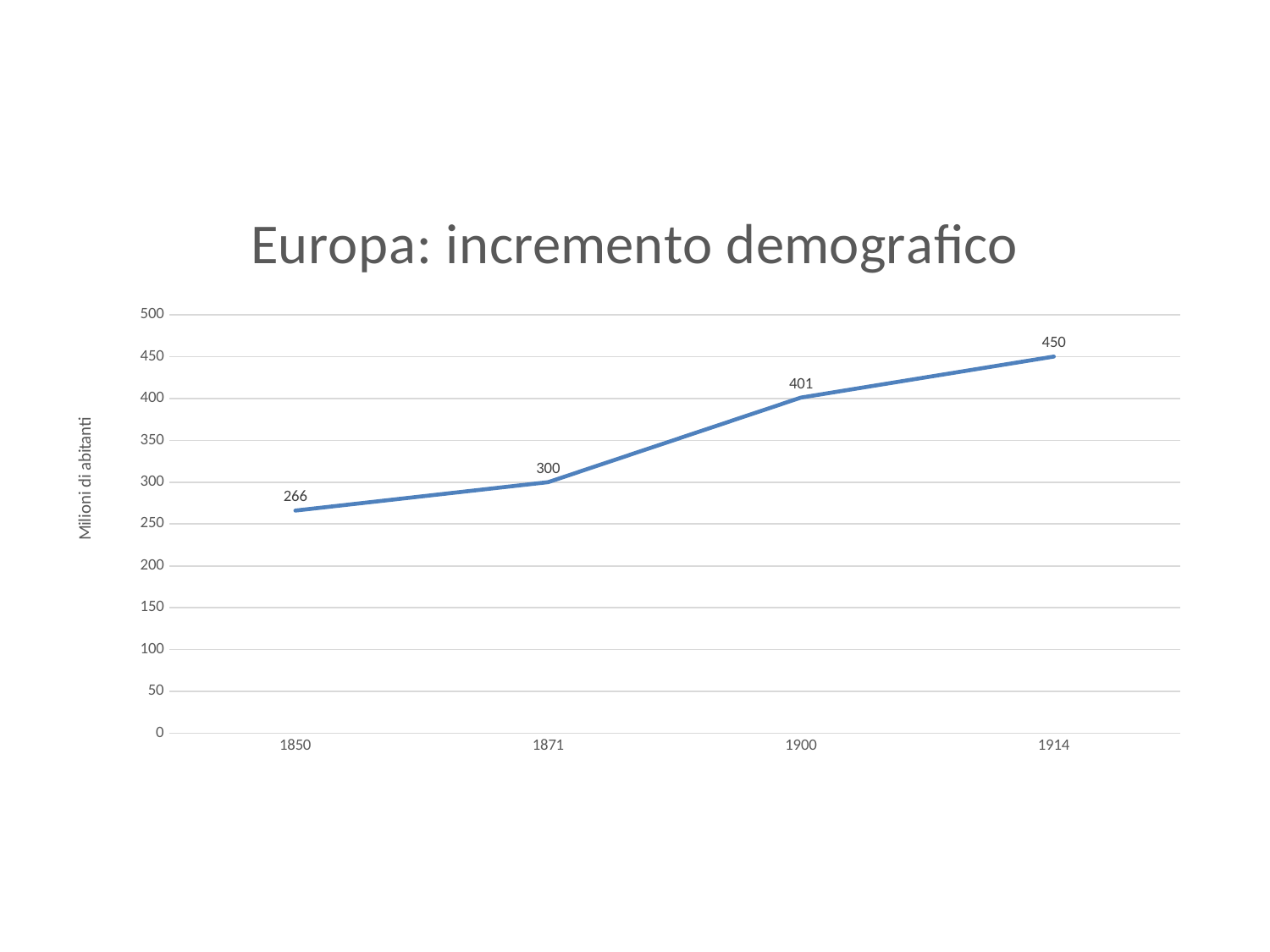
Which is larger, the value for 1871 or the value for 1900? 1900 What is the value for 1850? 266 What is the difference between the values for 1900 and 1871? 101 Do the values rise or fall from 1850 to 1914? Rise Which year has the highest value? 1914 What is the value for 1914? 450 How many data points are plotted on the chart? 4 Which year has the lowest value? 1850 What is the difference between the values for 1914 and 1850? 184 What is the value for 1900? 401 What kind of chart is shown on the slide? Line chart What is the value for 1871? 300